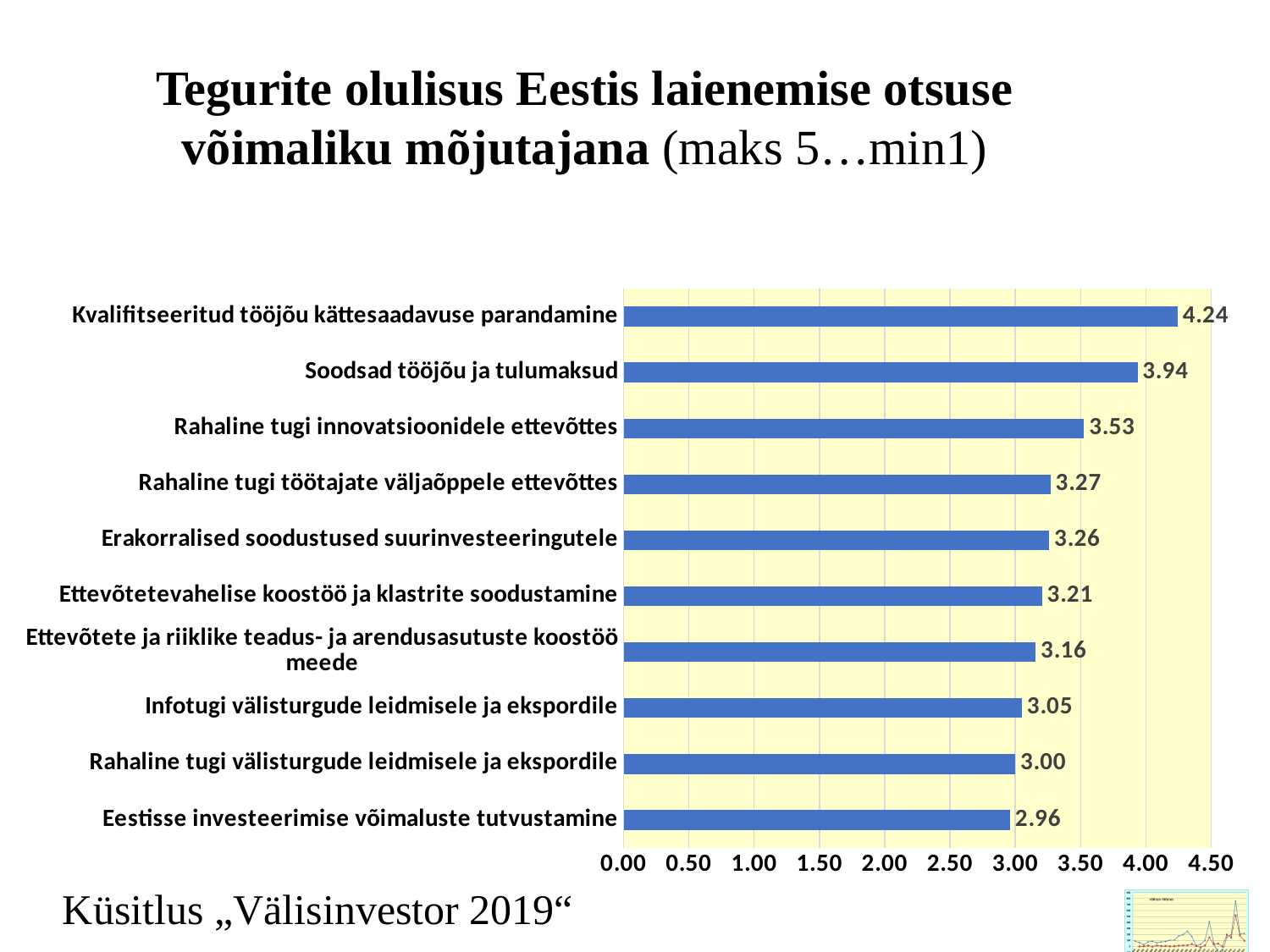
What is the maximum value shown on the horizontal axis? 4.50 What is the value for "Rahaline tugi innovatsioonidele ettevõttes"? 3.53 Which is larger: the value for "Infotugi välisturgude leidmisele ja ekspordile" or for "Ettevõtetevahelise koostöö ja klastrite soodustamine"? Ettevõtetevahelise koostöö ja klastrite soodustamine What kind of chart is shown on the slide? Bar chart Which category has the lowest value? Eestisse investeerimise võimaluste tutvustamine Is the value for "Soodsad tööjõu ja tulumaksud" greater or less than 3.50? greater How many categories are shown in the chart? 10 What is the value for "Kvalifitseeritud tööjõu kättesaadavuse parandamine"? 4.24 What is the difference between the values for "Soodsad tööjõu ja tulumaksud" and "Rahaline tugi välisturgude leidmisele ja ekspordile"? 0.94 Which category has the highest value? Kvalifitseeritud tööjõu kättesaadavuse parandamine What is the value for "Eestisse investeerimise võimaluste tutvustamine"? 2.96 What is the value for "Rahaline tugi töötajate väljaõppele ettevõttes"? 3.27